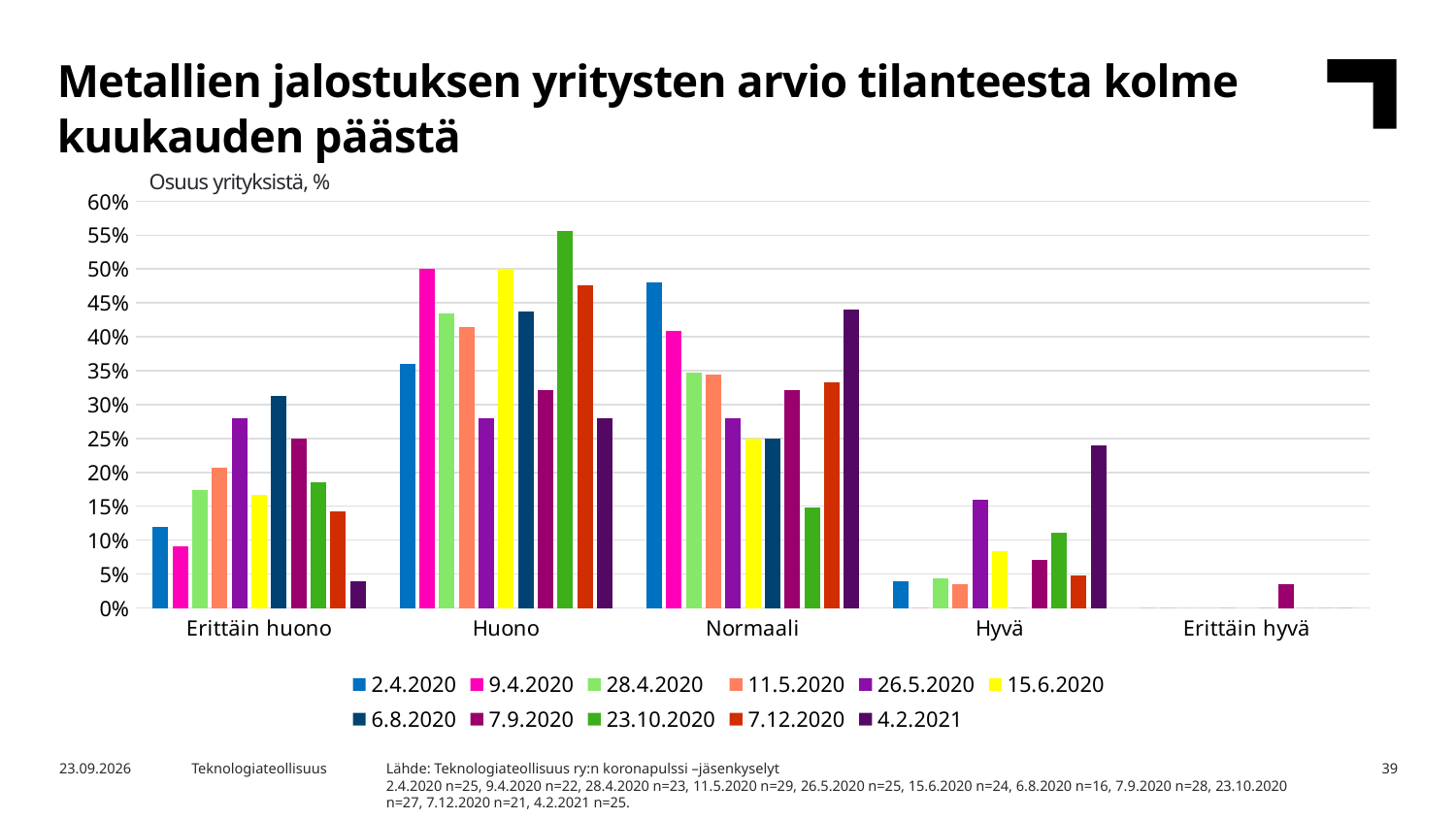
Is the value for 4.2.2021 in the 'Erittäin huono' category greater or less than 5%? less Is the value for 2.4.2020 in the 'Normaali' category greater or less than 45%? greater In the 'Hyvä' category, which is larger: the value for 4.2.2021 or the value for 26.5.2020? 4.2.2021 What is the label shown above the vertical axis of the chart? Osuus yrityksistä, % How many categories are shown on the x axis of the chart? 5 What type of chart is shown on the slide? bar chart In the 'Huono' category, which series has the highest value? 23.10.2020 Is the value for 23.10.2020 in the 'Normaali' category greater or less than 20%? less In the 'Erittäin huono' category, which series has the highest value? 6.8.2020 How many series does the legend list? 11 In the 'Erittäin huono' category, which series has the lowest value? 4.2.2021